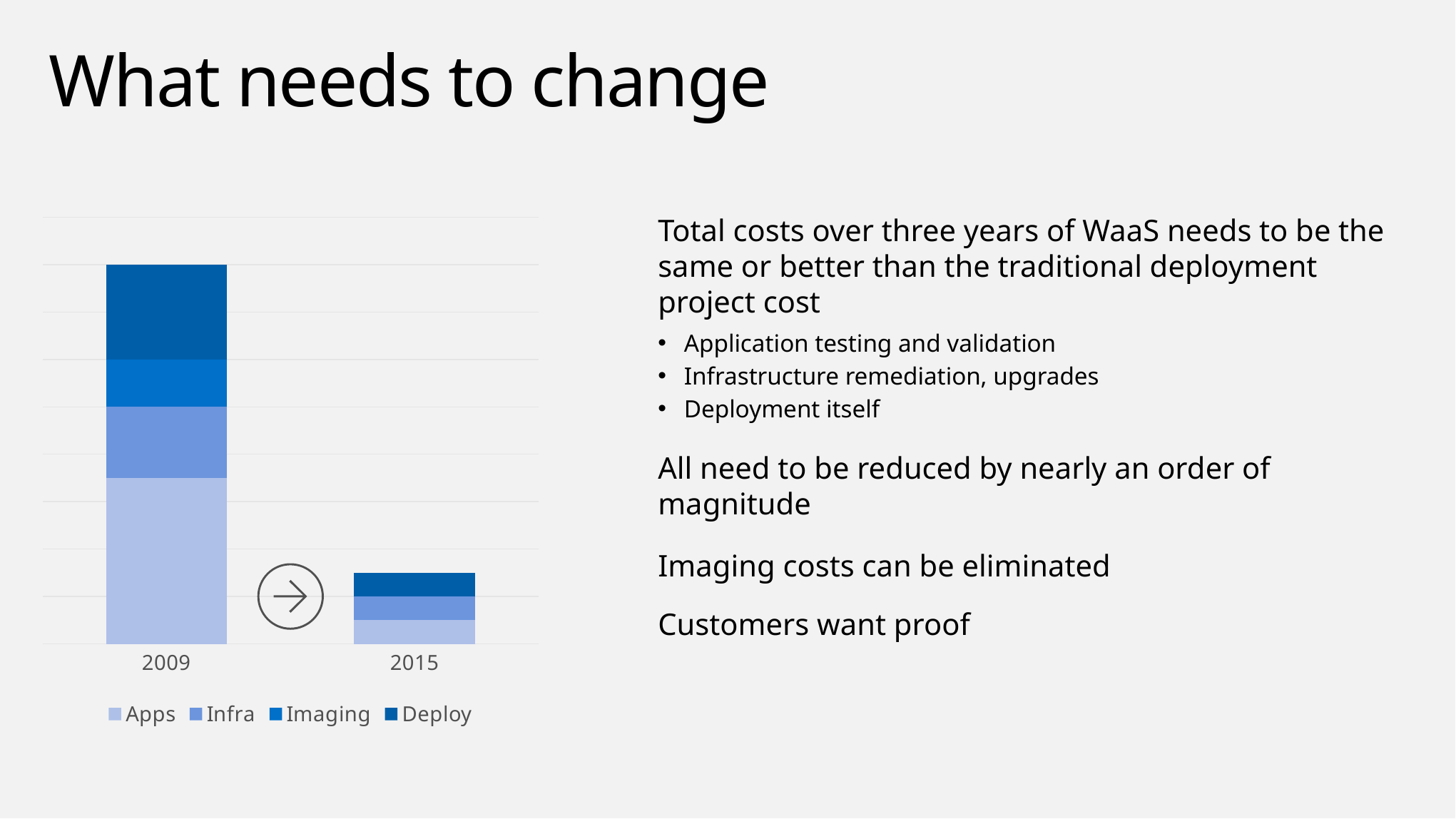
Which series are listed in the chart's legend? Apps, Infra, Imaging, Deploy Is the Apps segment larger in 2009 or in 2015? 2009 Which year has the taller stacked bar, 2009 or 2015? 2009 Do the total bar heights rise or fall from 2009 to 2015? Fall How many categories are shown on the x axis of the chart? 2 Which series forms the smallest segment of the 2009 bar? Imaging How many series does the chart's legend list? 4 What kind of chart is shown on the slide? Stacked bar chart Which category has the lowest total bar? 2015 Which category has the highest total bar? 2009 Which series forms the largest segment of the 2009 bar? Apps Which series is at the bottom of each stacked bar? Apps